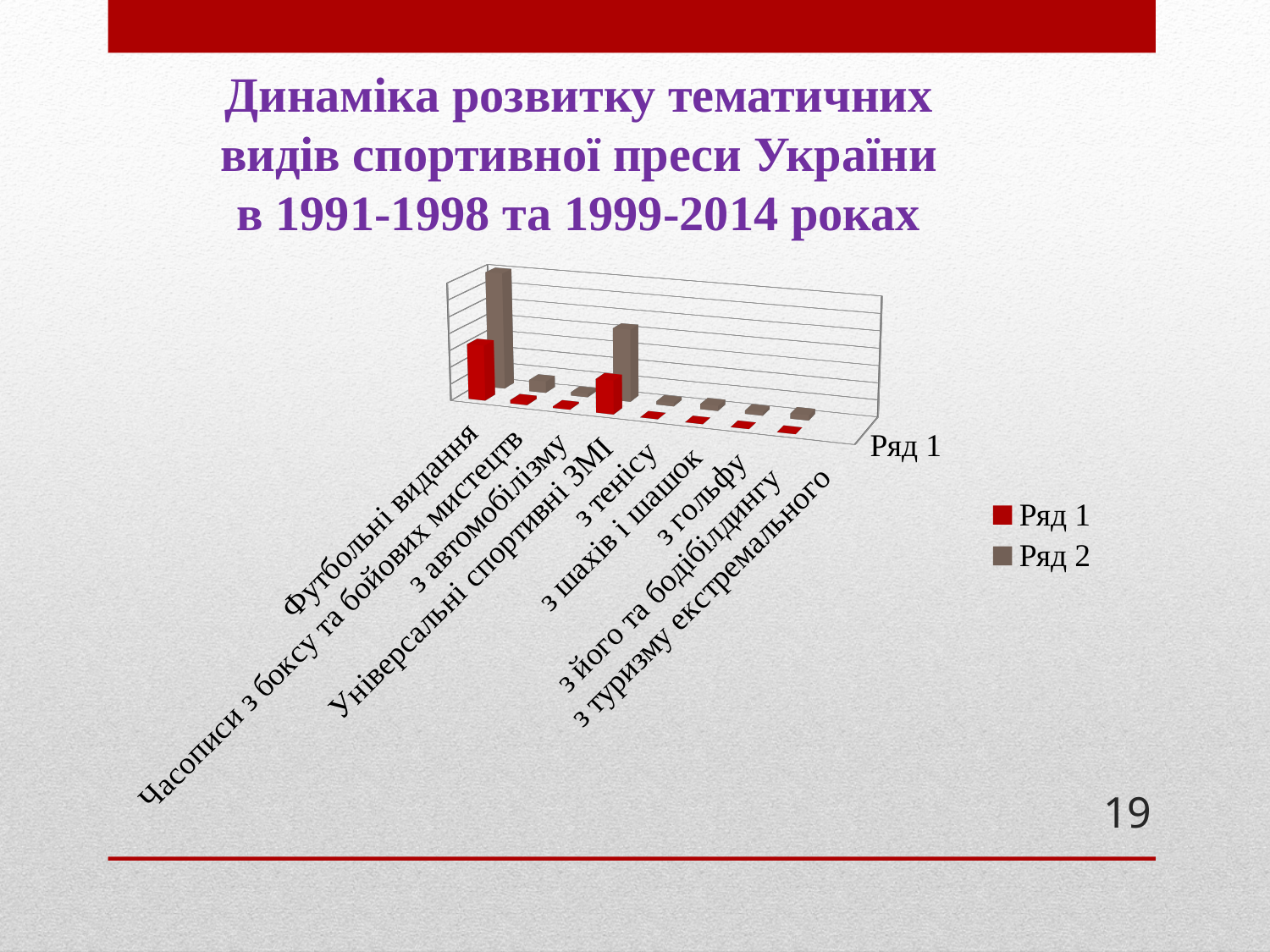
What kind of chart is shown on the slide? bar chart How many series does the chart legend list? 2 Which category has the highest value for Ряд 1? Футбольні видання What are the two series names listed in the chart legend? Ряд 1, Ряд 2 For Футбольні видання, which series has the larger value, Ряд 1 or Ряд 2? Ряд 2 For Ряд 2, which category has the larger value: Універсальні спортивні ЗМІ or з автомобілізму? Універсальні спортивні ЗМІ How many categories are shown along the x axis of the chart? 9 Which category has the highest value for Ряд 2? Футбольні видання For Ряд 2, which category has the larger value: Футбольні видання or Універсальні спортивні ЗМІ? Футбольні видання Which colour represents Ряд 1 in the chart? red